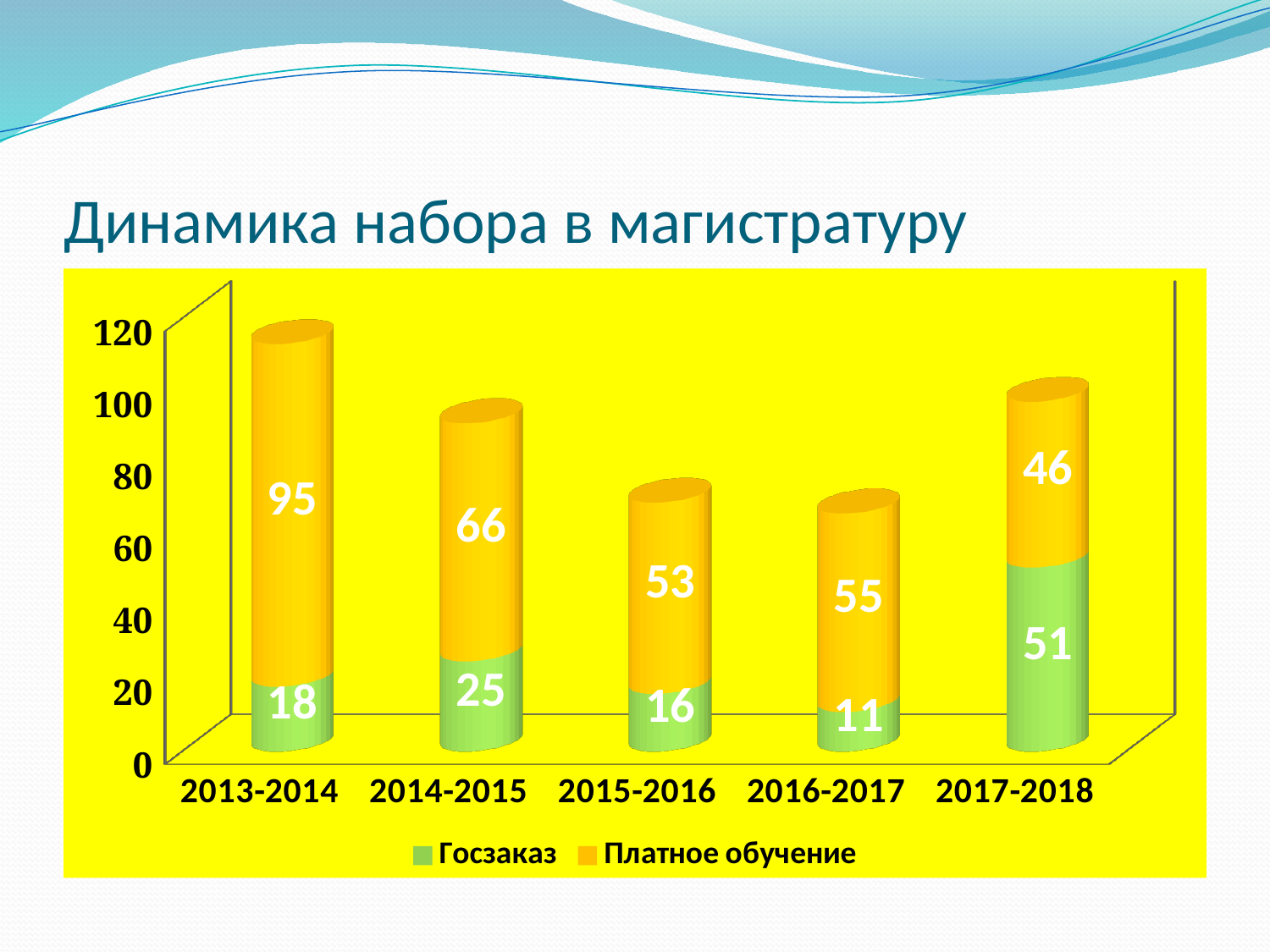
What is the value for Платное обучение in 2017-2018? 46 How many series does the legend list? 2 What is the total of the stacked bar for 2013-2014? 113 Which year has the highest value for Госзаказ? 2017-2018 Which year has the lowest value for Платное обучение? 2017-2018 Which is larger: Госзаказ in 2016-2017 or Госзаказ in 2014-2015? Госзаказ in 2014-2015 What is the value for Госзаказ in 2013-2014? 18 How many years are shown on the x axis? 5 What is the difference between the Платное обучение values for 2013-2014 and 2014-2015? 29 What is the total of the stacked bar for 2017-2018? 97 What is the value for Платное обучение in 2015-2016? 53 What kind of chart is shown on the slide? Stacked bar chart